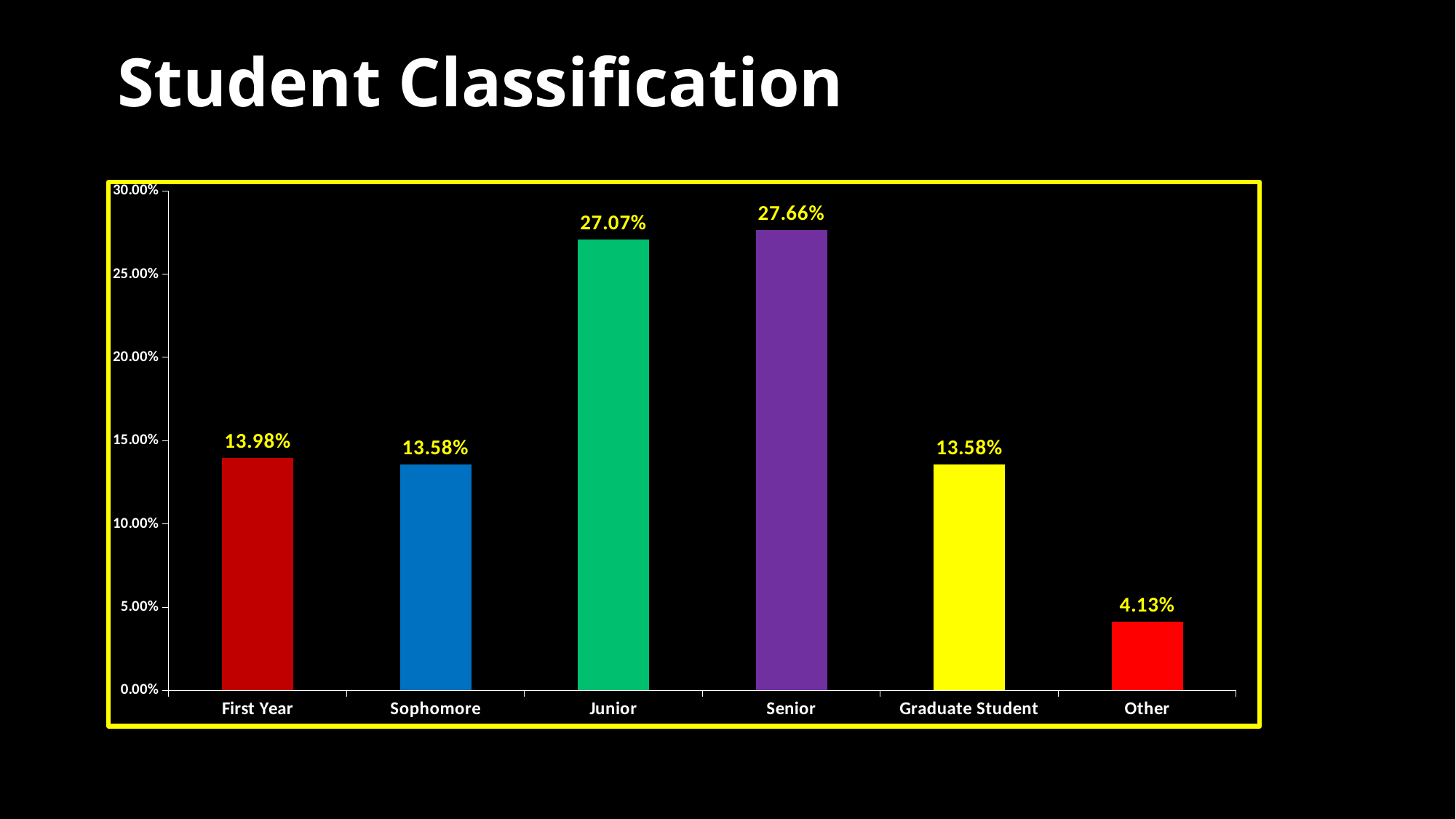
Which category has the lowest value? Other What is the difference between the values for Senior and Junior? 0.59% How many categories are shown on the x axis? 6 What is the difference between the values for First Year and Other? 9.85% Which category has the highest value? Senior Which is larger, the value for First Year or the value for Sophomore? First Year What is the value for Junior? 27.07% What kind of chart is shown on the slide? bar chart What is the value for First Year? 13.98% What is the title of the slide? Student Classification What is the value for Other? 4.13% Is the value for Graduate Student greater or less than 15.00%? less